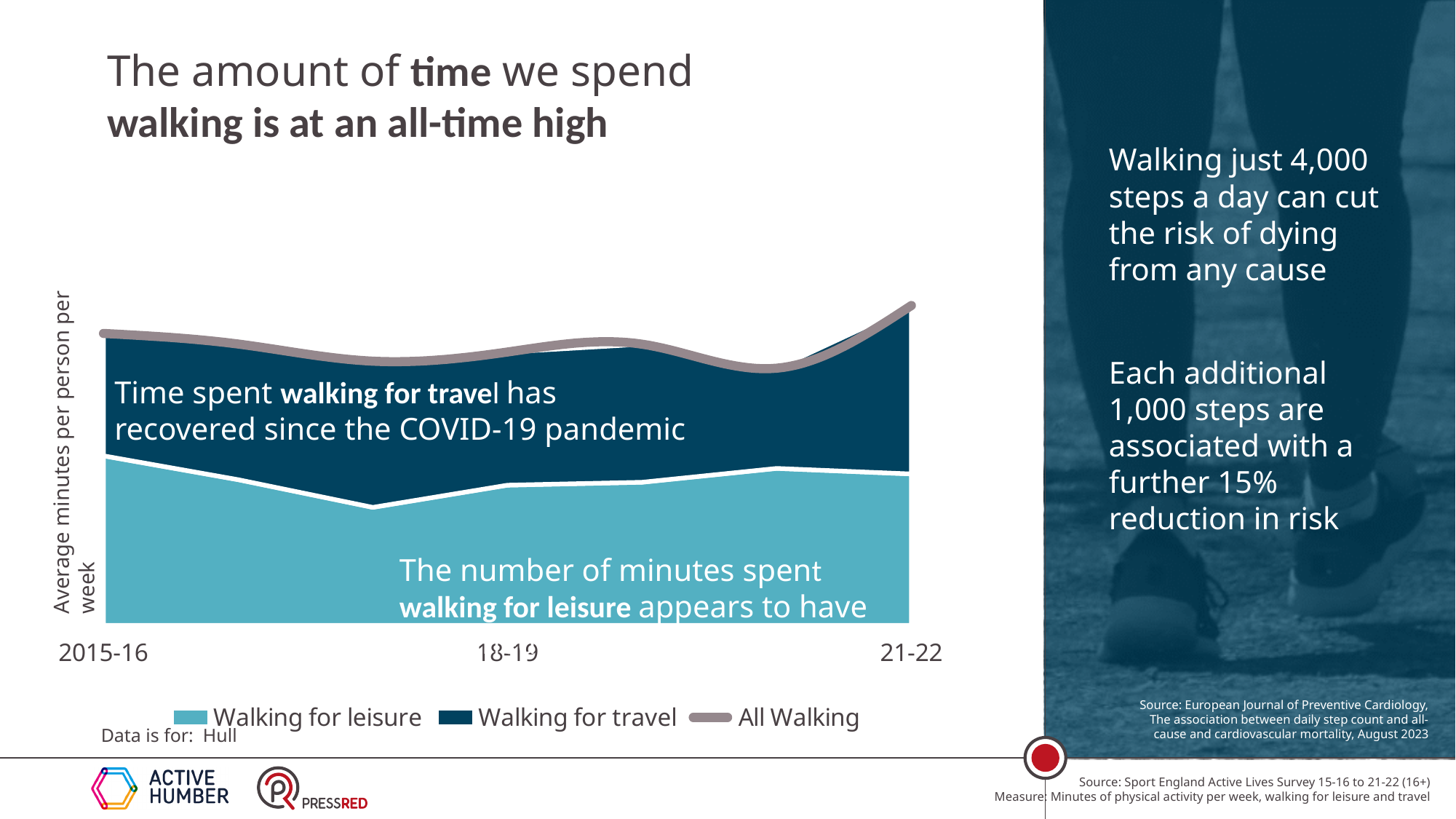
In 2015-16, which is larger: the minutes spent walking for leisure or walking for travel? Walking for leisure How many series does the chart legend list? 3 Which area does the chart's data cover? Hull What is the label on the chart's vertical axis? Average minutes per person per week What kind of chart is shown on the slide? Stacked area chart with a line How many yearly data points are plotted along the x axis? 7 Does the All Walking line rise or fall between 18-19 and 21-22 overall? Rise What is the first period shown on the chart's x axis? 2015-16 What are the three series listed in the chart legend? Walking for leisure, Walking for travel, All Walking What is the last period shown on the chart's x axis? 21-22 In which period is the All Walking line at its highest? 21-22